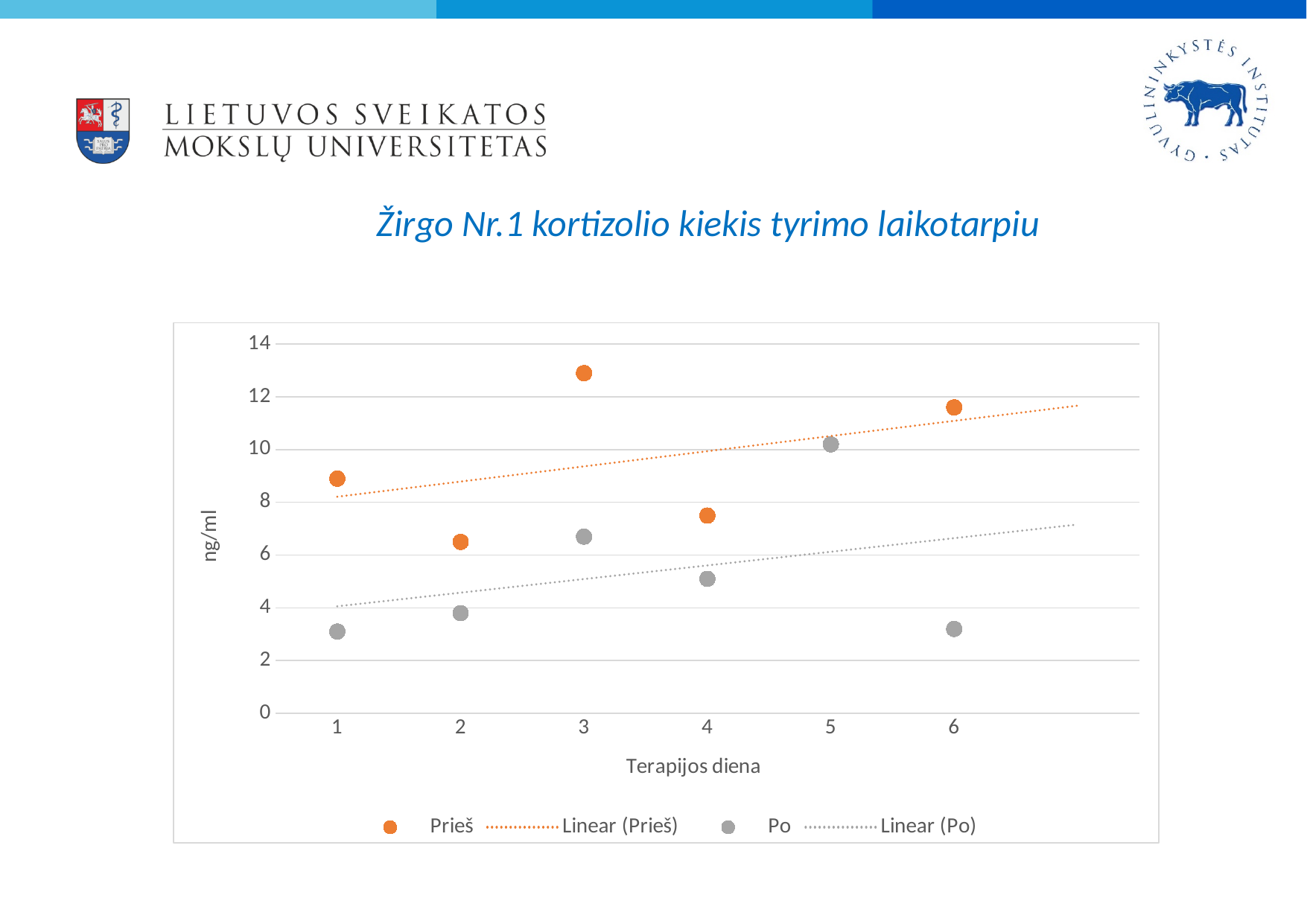
On which therapy day is the Prieš value lowest? 2 What kind of chart is shown on the slide? scatter chart On day 1, which is larger: the Prieš value or the Po value? Prieš How many therapy days (Terapijos diena) are marked on the x axis? 6 What is the title of the chart? Žirgo Nr.1 kortizolio kiekis tyrimo laikotarpiu Is the Po value on day 1 greater or less than 4? less On which therapy day is the Po value highest? 5 How many entries does the chart legend list? 4 On which therapy day is the Prieš value highest? 3 Is the Prieš value on day 3 greater or less than 12? greater What is the label of the y axis? ng/ml